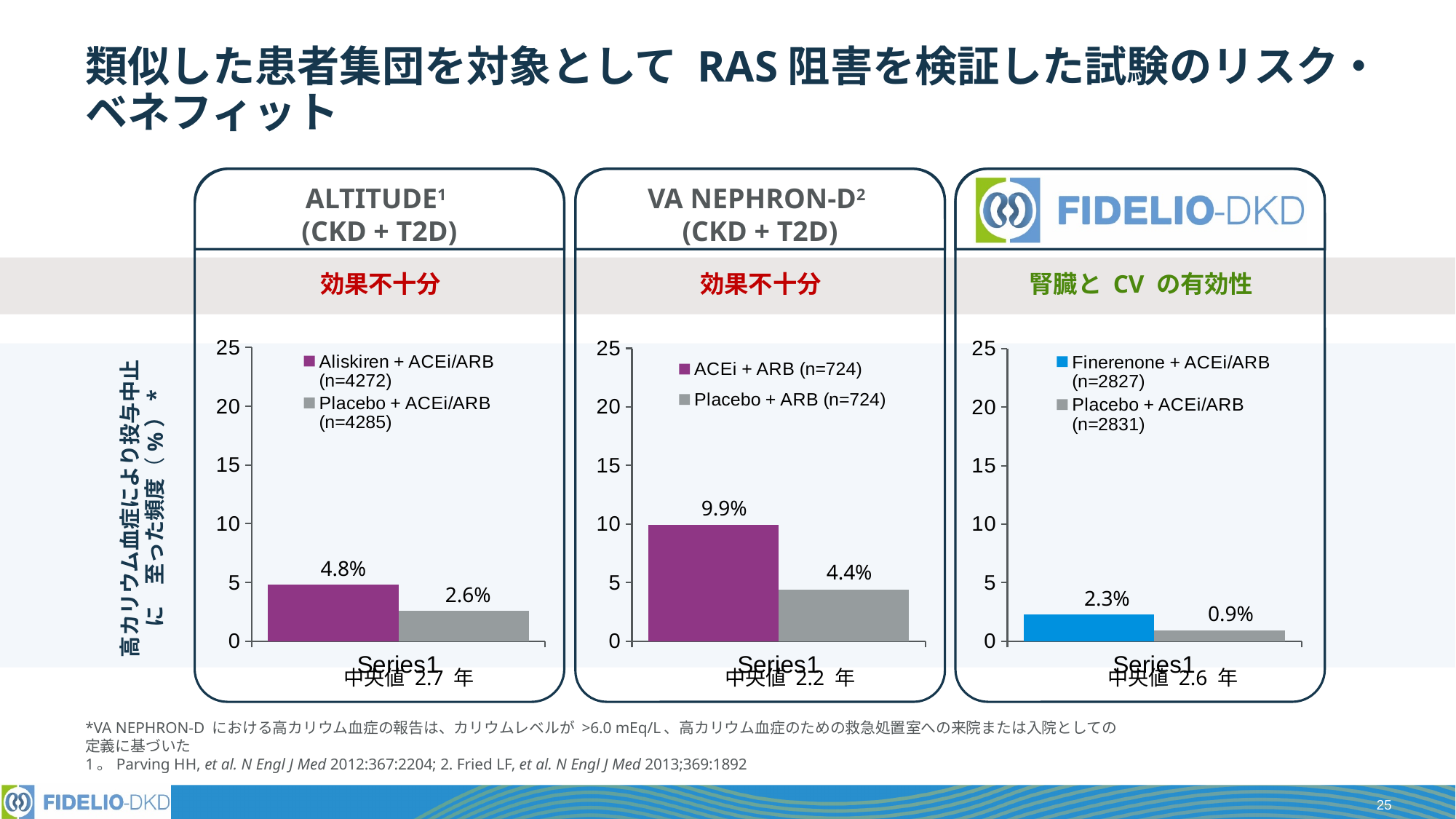
In the ALTITUDE chart, what is the value for Aliskiren + ACEi/ARB (n=4272)? 4.8% In the ALTITUDE chart, what is the value for Placebo + ACEi/ARB (n=4285)? 2.6% In the FIDELIO-DKD chart, what is the value for Finerenone + ACEi/ARB (n=2827)? 2.3% In the VA NEPHRON-D chart, what is the difference between the ACEi + ARB value and the Placebo + ARB value? 5.5% In the VA NEPHRON-D chart, what is the value for ACEi + ARB (n=724)? 9.9% How many series does the legend of the FIDELIO-DKD chart list? 2 In the VA NEPHRON-D chart, what is the value for Placebo + ARB (n=724)? 4.4% In the ALTITUDE chart, what is the difference between the Aliskiren + ACEi/ARB value and the Placebo + ACEi/ARB value? 2.2% In the FIDELIO-DKD chart, which series has the higher value, Finerenone + ACEi/ARB or Placebo + ACEi/ARB? Finerenone + ACEi/ARB In the VA NEPHRON-D chart, is the value for ACEi + ARB greater or less than 5? greater What kind of chart is the ALTITUDE chart? bar chart In the FIDELIO-DKD chart, what is the value for Placebo + ACEi/ARB (n=2831)? 0.9%